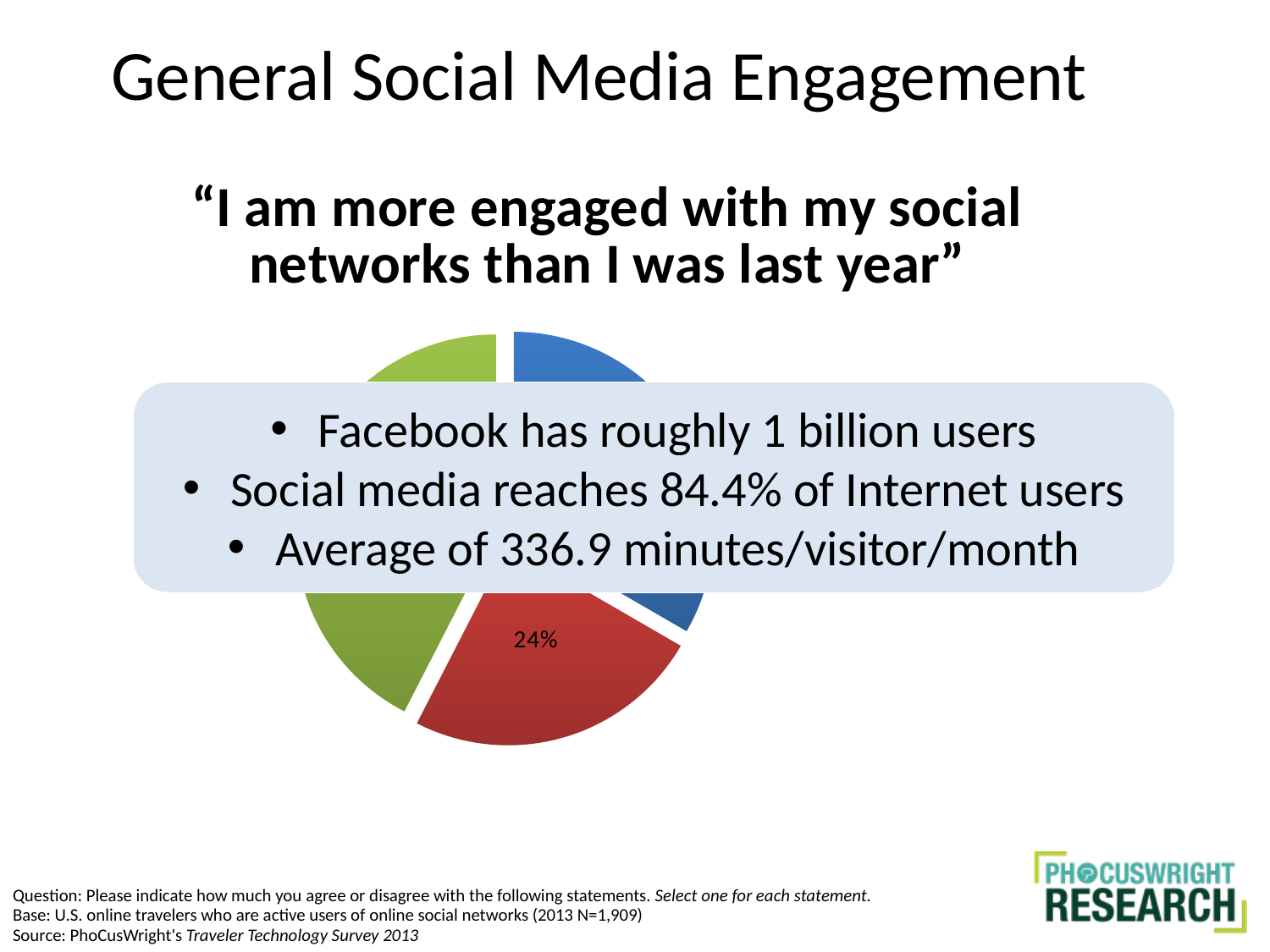
What percentage is printed on the red slice of the pie chart? 24% What kind of chart is shown on the slide? pie chart What colour is the pie slice labelled 24%? red What statement is the pie chart about, according to the heading above it? "I am more engaged with my social networks than I was last year"